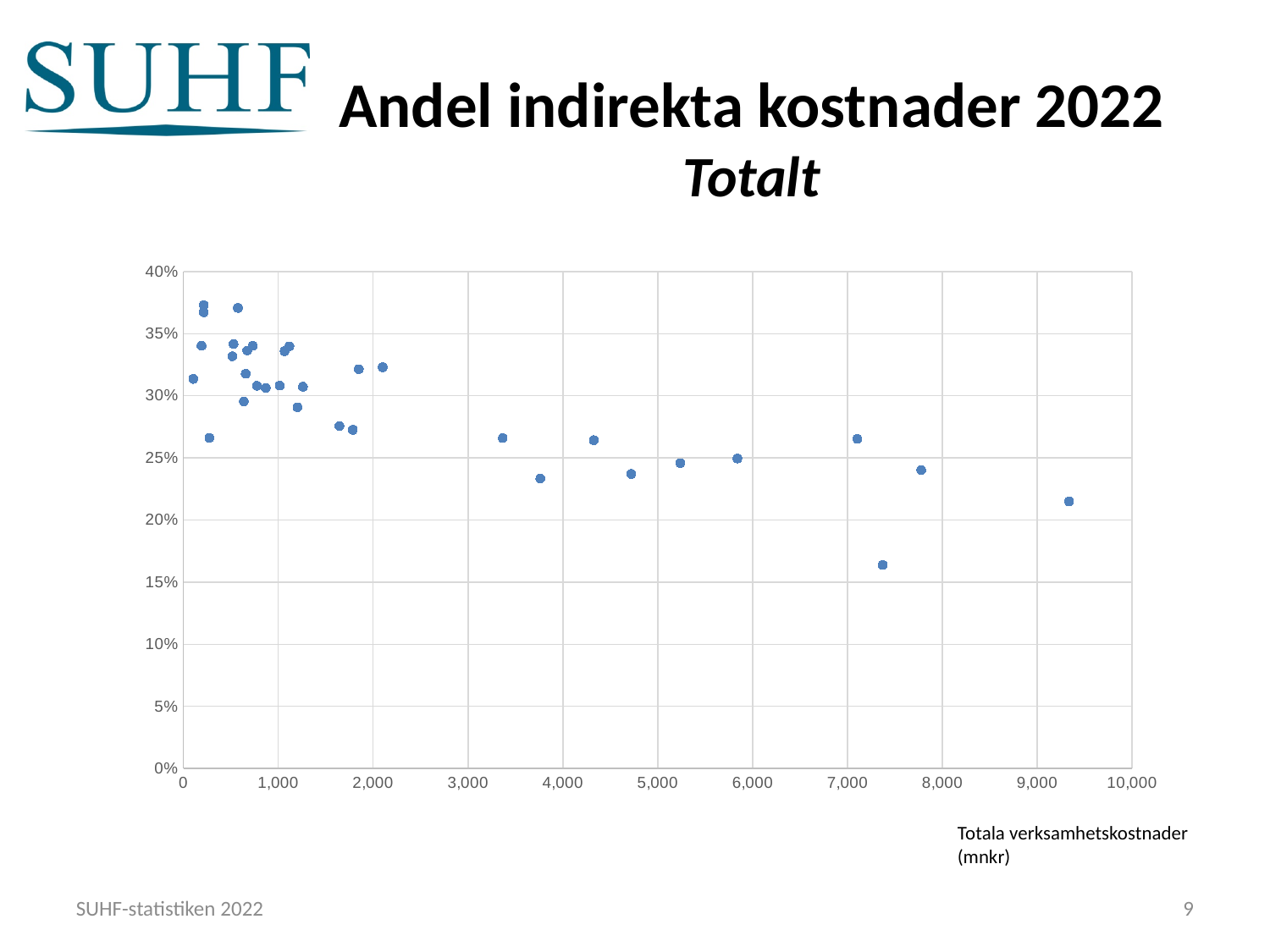
Is the value for the point near 5,800 on the x axis greater or less than 30%? less What kind of chart is shown on the slide? Scatter chart Are all points with x values above 3,000 below 30%? Yes Do the plotted values generally rise or fall as the x-axis value (total costs) increases? Fall Is the value for the point near 7,800 on the x axis greater or less than 20%? greater What label is given for the x axis of the chart? Totala verksamhetskostnader (mnkr) Which is larger: the value for the point near 7,100 on the x axis or the value for the point near 7,400 on the x axis? The point near 7,100 What is the title of the chart on the slide? Andel indirekta kostnader 2022 Totalt What is the highest value shown on the y axis of the chart? 40%